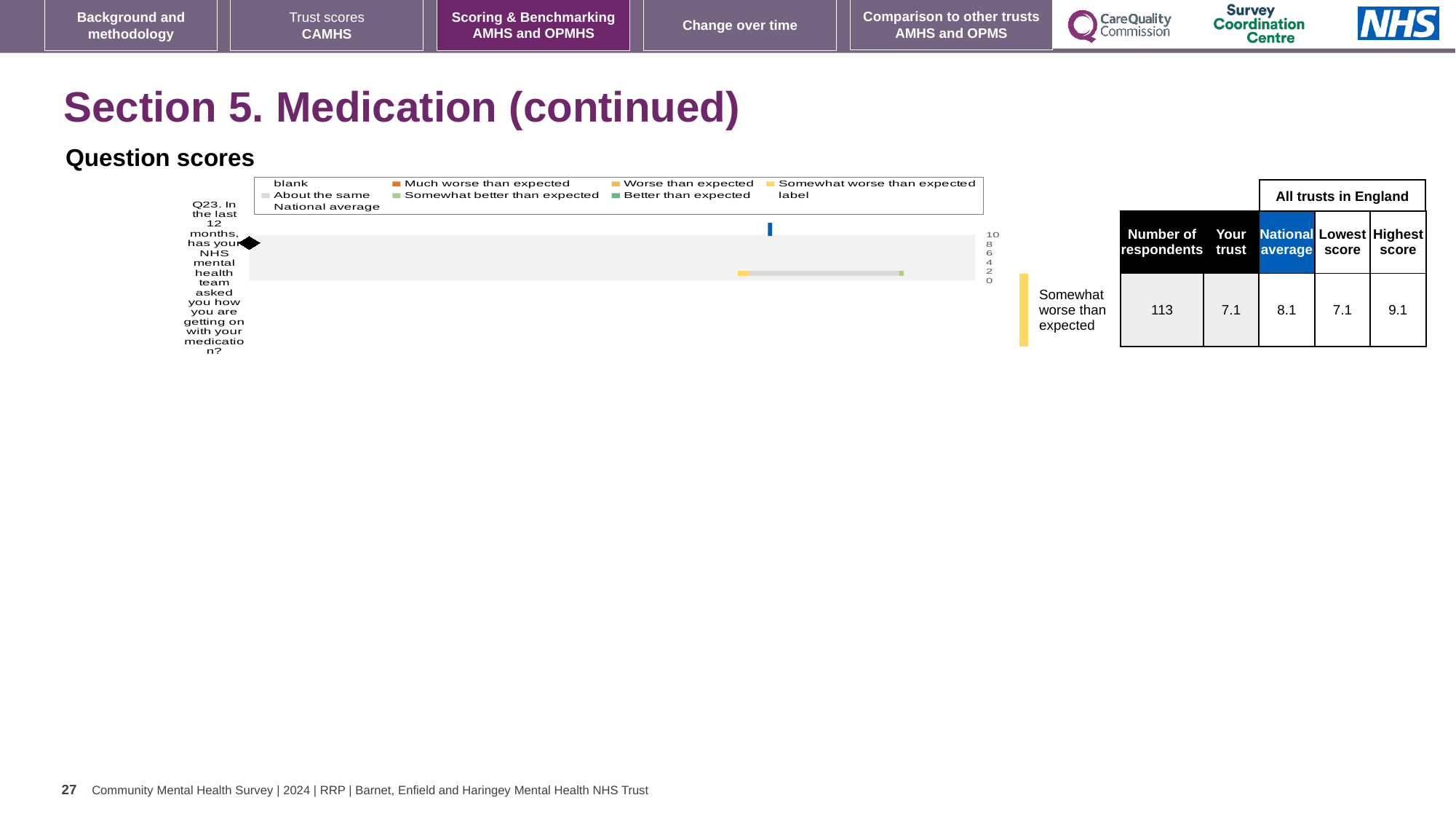
What kind of chart is used to show the Q23 question score? bar chart What is the national average score for Q23? 8.1 What is the number of respondents for Q23 in the table next to the chart? 113 How much higher is the national average than the 'Your trust' score for Q23? 1.0 What is the maximum value shown on the chart's score axis? 10 How many survey questions are plotted in the question scores chart? 1 What is the 'Your trust' score for Q23? 7.1 Which benchmark category is Q23 assigned to on this slide? Somewhat worse than expected What is the lowest score among all trusts in England for Q23? 7.1 What is the highest score among all trusts in England for Q23? 9.1 For Q23, which is larger: the 'Your trust' score or the national average? National average What is the difference between the highest score and the lowest score for Q23? 2.0